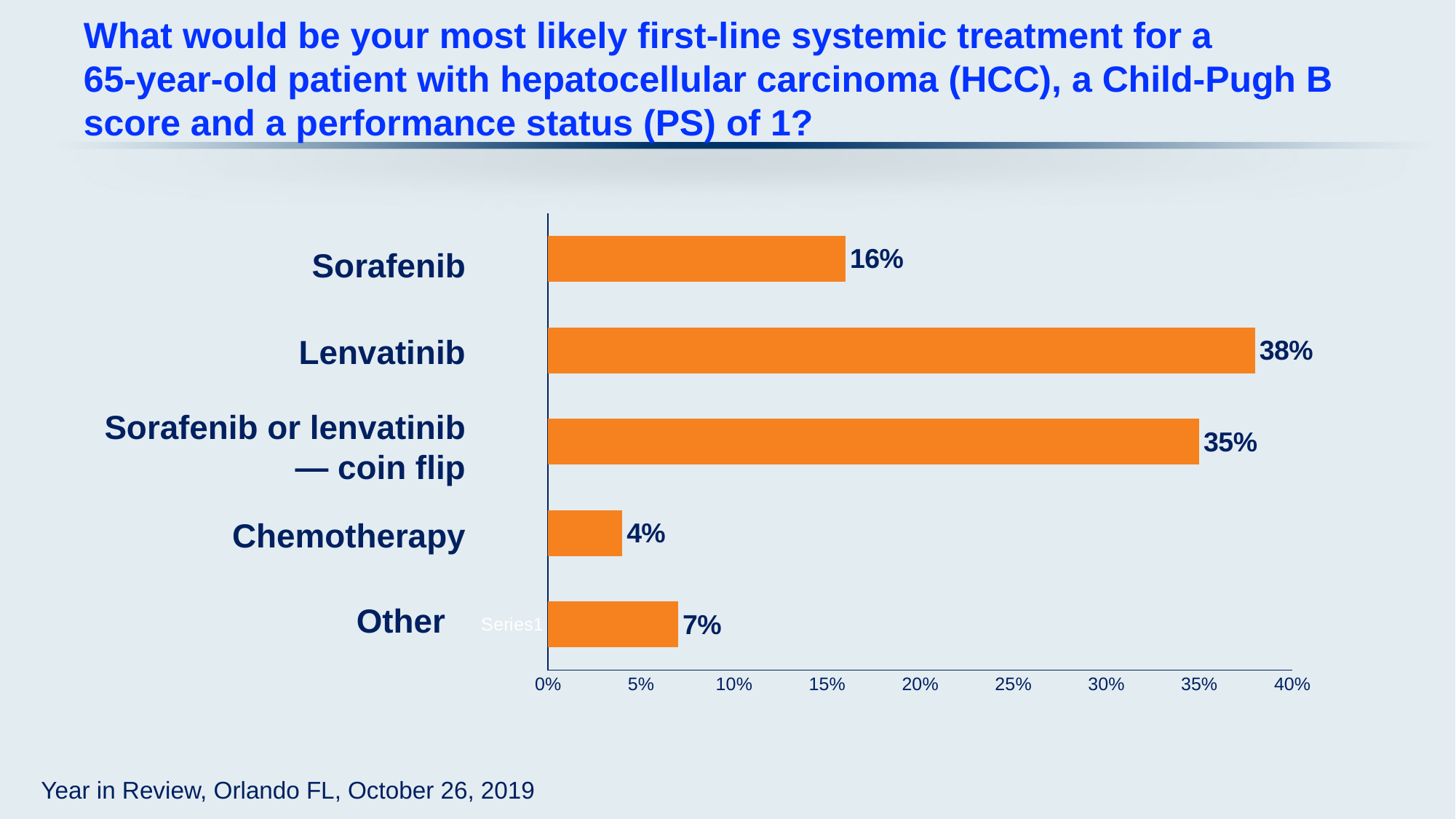
What type of chart is shown on the slide? Bar chart What is the value shown for Sorafenib? 16% What is the maximum value shown on the horizontal axis? 40% Which treatment option has the lowest percentage? Chemotherapy What percentage of respondents chose Lenvatinib? 38% Which treatment option has the highest percentage? Lenvatinib What percentage is shown for Chemotherapy? 4% What is the difference between 'Sorafenib or lenvatinib — coin flip' and 'Other'? 28 What is the difference in percentage points between Lenvatinib and Sorafenib? 22 How many treatment categories are shown in the chart? 5 What is the value for the 'Other' category? 7% Which has a larger value, Sorafenib or 'Other'? Sorafenib